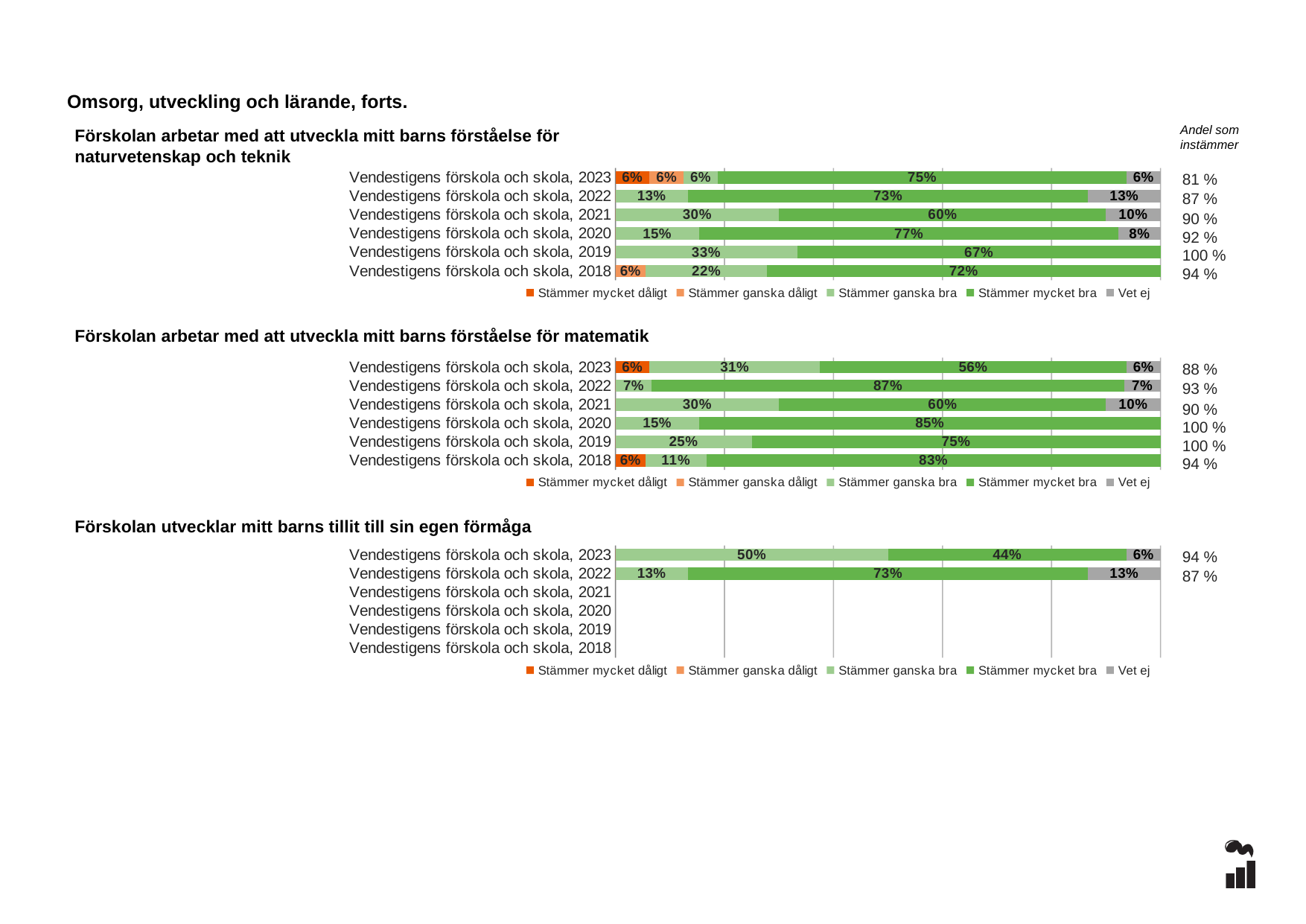
In the chart 'Förskolan arbetar med att utveckla mitt barns förståelse för naturvetenskap och teknik', what is the 'Stämmer ganska bra' value for Vendestigens förskola och skola, 2019? 33% In the chart 'Förskolan arbetar med att utveckla mitt barns förståelse för naturvetenskap och teknik', which year has the highest 'Stämmer mycket bra' value? 2020 In the chart 'Förskolan arbetar med att utveckla mitt barns förståelse för matematik', what is the difference between the 'Stämmer mycket bra' values for 2020 and 2019? 10% In the chart 'Förskolan arbetar med att utveckla mitt barns förståelse för matematik', which is larger: the 'Stämmer ganska bra' value for 2023 or for 2021? 2023 How many series does the legend of the chart 'Förskolan arbetar med att utveckla mitt barns förståelse för matematik' list? 5 In the chart 'Förskolan arbetar med att utveckla mitt barns förståelse för matematik', which year has the lowest 'Stämmer mycket bra' value? 2023 In the chart 'Förskolan arbetar med att utveckla mitt barns förståelse för naturvetenskap och teknik', what is the 'Stämmer mycket bra' value for Vendestigens förskola och skola, 2020? 77% In the chart 'Förskolan utvecklar mitt barns tillit till sin egen förmåga', how many of the listed years have plotted bars? 2 In the chart 'Förskolan arbetar med att utveckla mitt barns förståelse för matematik', what is the 'Stämmer mycket bra' value for Vendestigens förskola och skola, 2022? 87% In the chart 'Förskolan utvecklar mitt barns tillit till sin egen förmåga', what is the 'Stämmer ganska bra' value for Vendestigens förskola och skola, 2023? 50% In the chart 'Förskolan utvecklar mitt barns tillit till sin egen förmåga', what is the 'Vet ej' value for Vendestigens förskola och skola, 2022? 13% What kind of chart is 'Förskolan utvecklar mitt barns tillit till sin egen förmåga'? Stacked bar chart